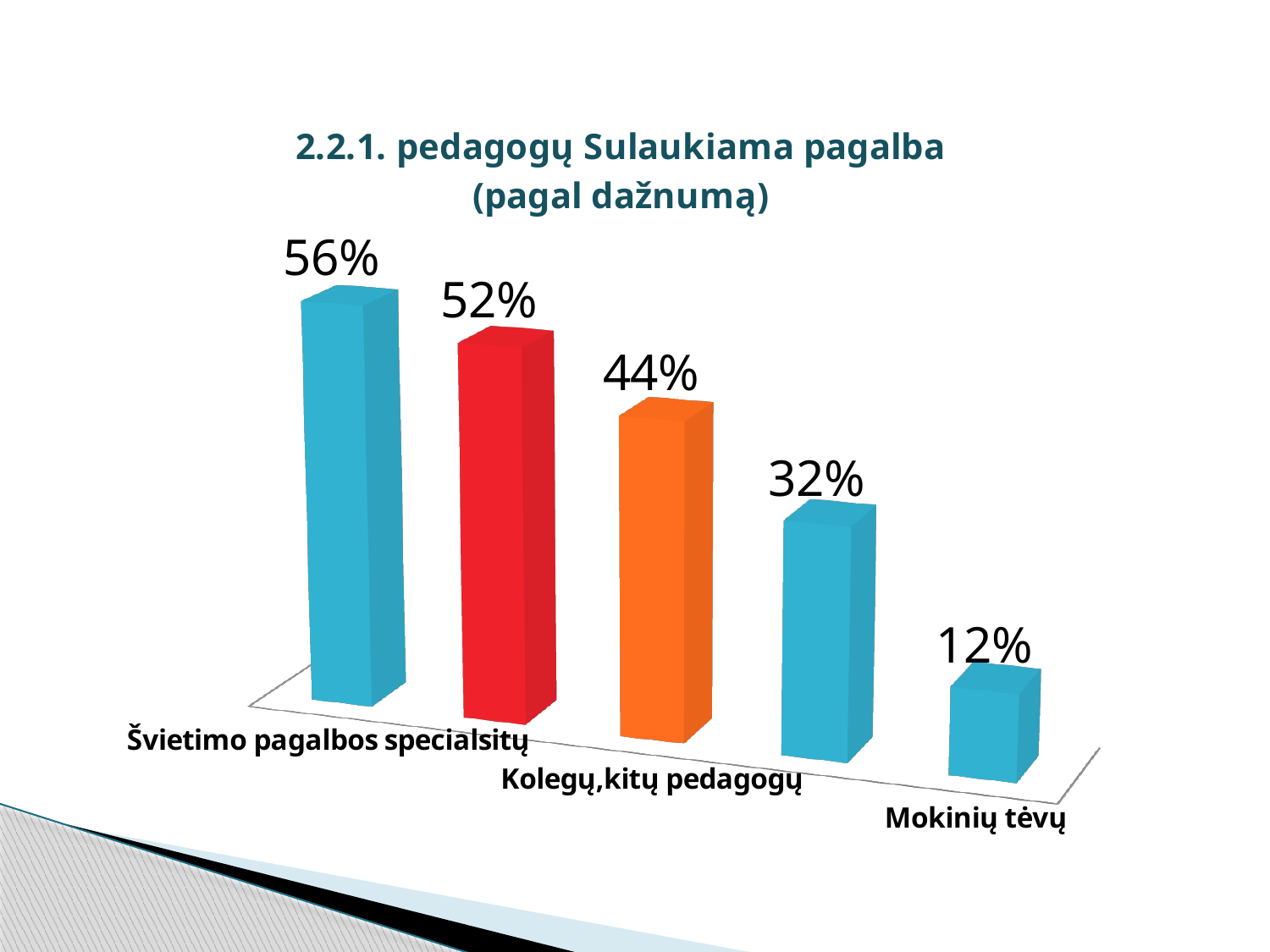
What is the value for Mokinių tėvų? 12% Which is larger, the value for Kolegų,kitų pedagogų or the value for Mokinių tėvų? Kolegų,kitų pedagogų What is the value for Švietimo pagalbos specialsitų? 56% What is the difference between the values for Kolegų,kitų pedagogų and Mokinių tėvų? 32% What is the value shown on the fourth bar from the left? 32% What is the value shown on the second bar from the left? 52% What is the value for Kolegų,kitų pedagogų? 44% What kind of chart is shown on the slide? Bar chart Which category has the lowest value? Mokinių tėvų Which category has the highest value? Švietimo pagalbos specialsitų How many bars does the chart show? 5 What is the difference between the values for Švietimo pagalbos specialsitų and Mokinių tėvų? 44%